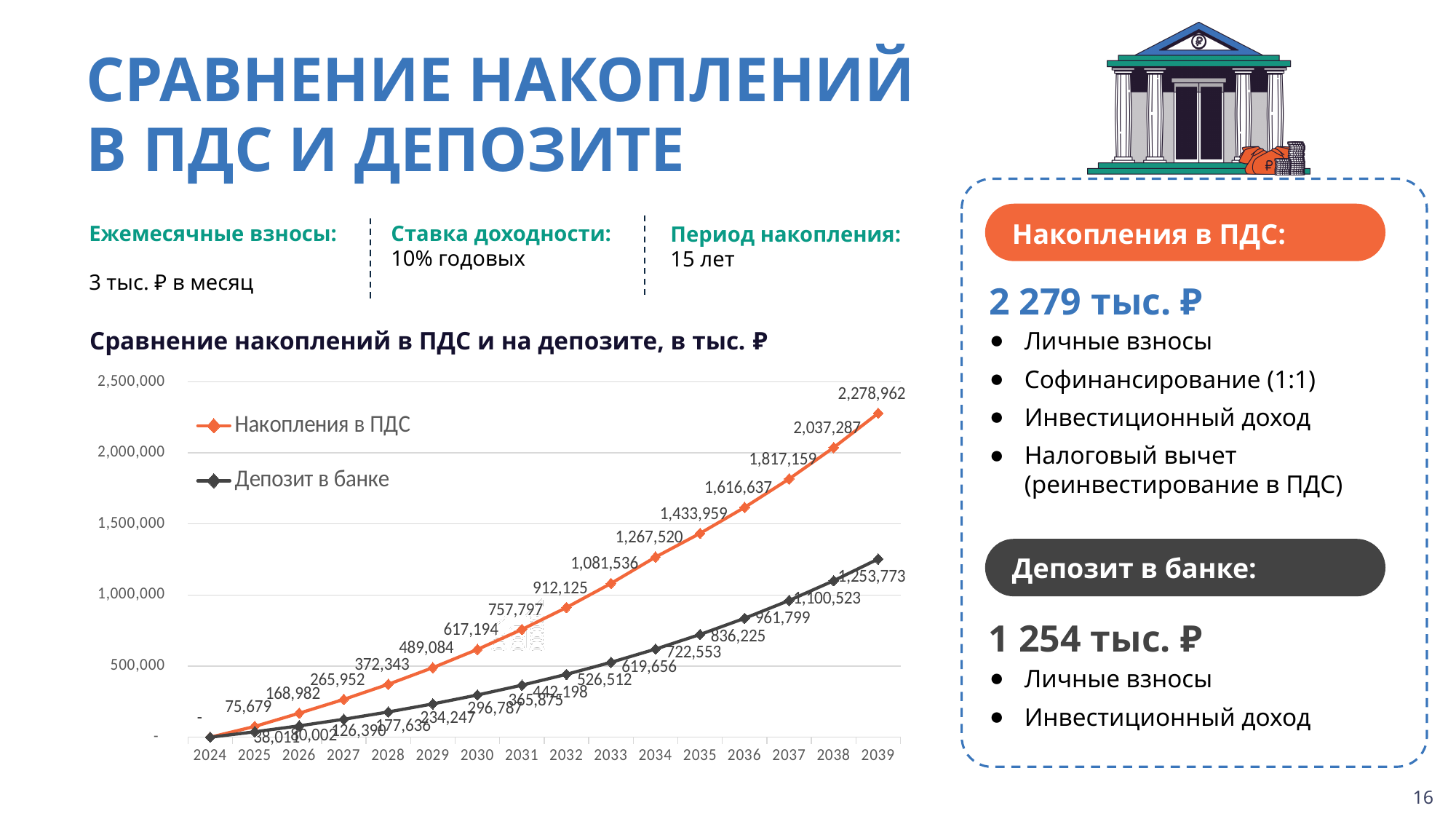
What is the difference between Накопления в ПДС and Депозит в банке in 2038? 936,764 What is the value for Накопления в ПДС in 2039? 2,278,962 What is the value for Депозит в банке in 2036? 836,225 Is the value for Депозит в банке in 2035 greater or less than 1,000,000? less What is the difference between Накопления в ПДС and Депозит в банке in 2039? 1,025,189 What is the value for Депозит в банке in 2039? 1,253,773 What kind of chart is shown on the slide? line chart Which series has the larger value in 2035, Накопления в ПДС or Депозит в банке? Накопления в ПДС What is the value for Накопления в ПДС in 2032? 912,125 Do the values for Накопления в ПДС rise or fall from 2024 to 2039? rise How many series does the chart legend list? 2 How many years are plotted along the x axis of the chart? 16